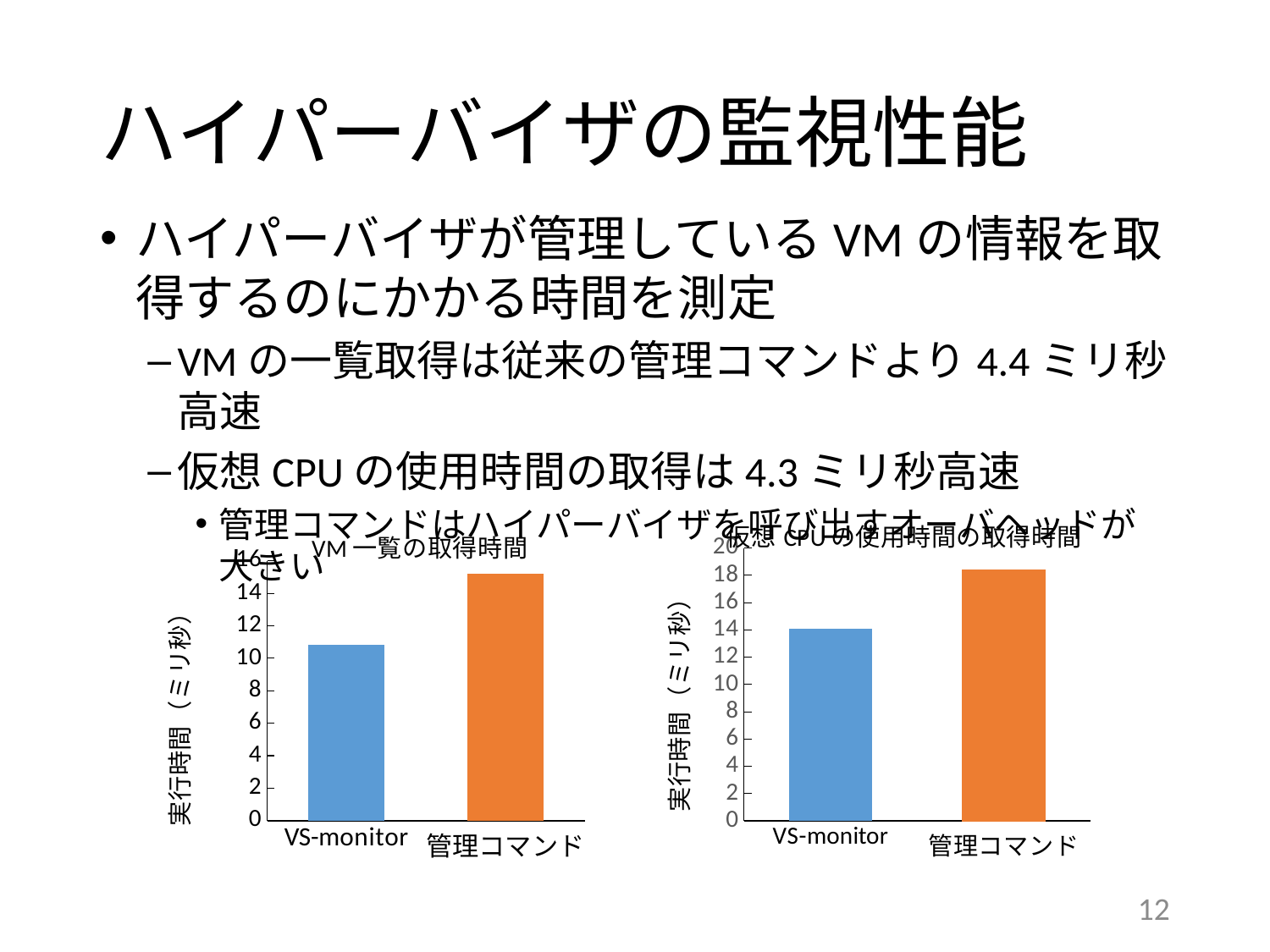
In the left chart (VM 一覧の取得時間), is the value for 管理コマンド greater or less than 14? greater In the left chart (VM 一覧の取得時間), which category has the higher value? 管理コマンド In the left chart (VM 一覧の取得時間), is the value for VS-monitor greater or less than 12? less What kind of chart is the left chart titled "VM 一覧の取得時間"? bar chart What is the maximum value shown on the y-axis of the right chart? 20 In the right chart, is the value for VS-monitor greater or less than 16? less How many categories are shown in the left chart (VM 一覧の取得時間)? 2 In the right chart, which category has the higher value, VS-monitor or 管理コマンド? 管理コマンド In the left chart (VM 一覧の取得時間), which category has the lower value? VS-monitor What is the y-axis label of the left chart (VM 一覧の取得時間)? 実行時間（ミリ秒）